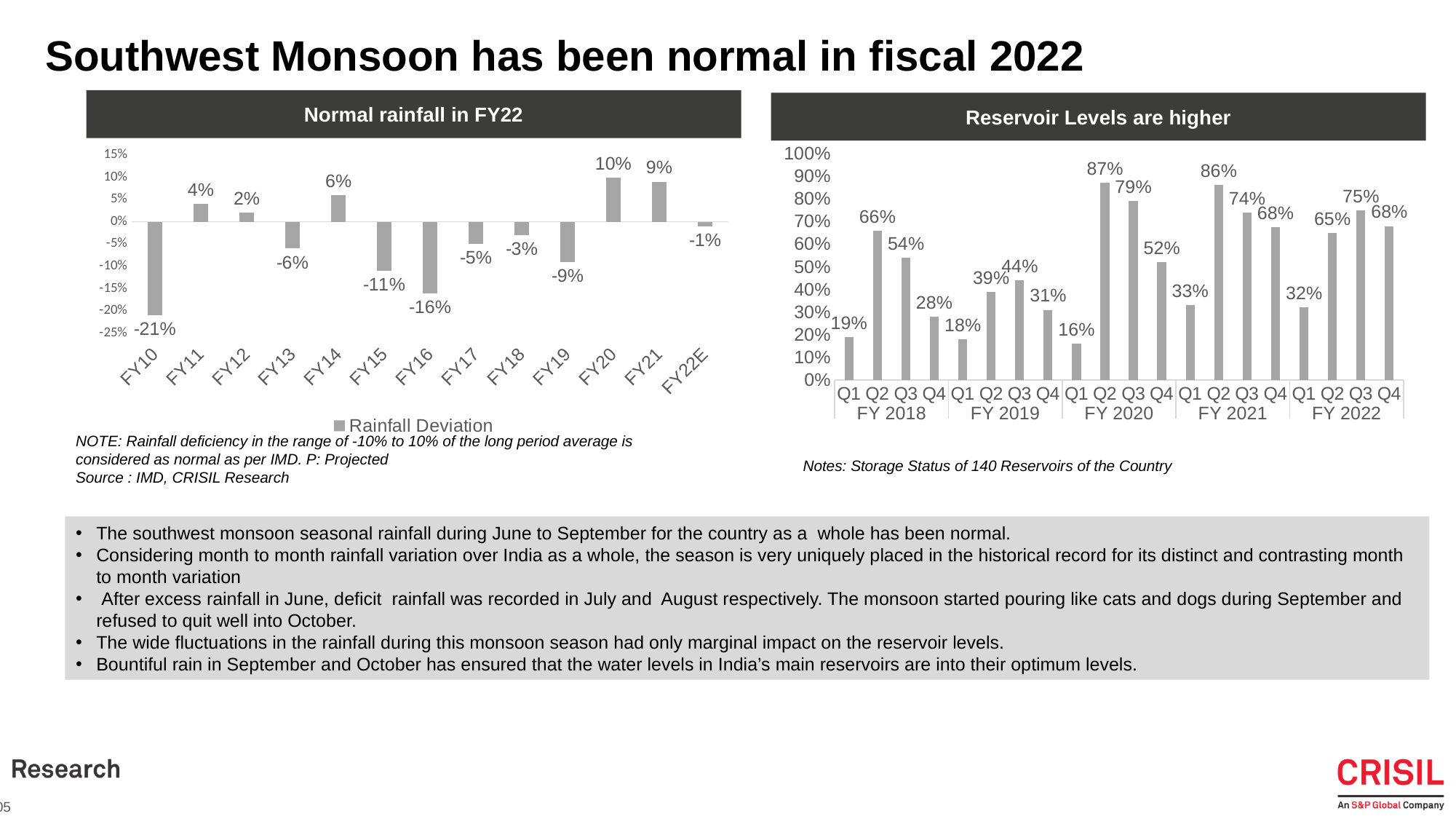
In the 'Reservoir Levels are higher' chart, how many quarterly bars are plotted? 20 In the 'Reservoir Levels are higher' chart, what is the reservoir level in Q2 of FY 2020? 87% In the 'Normal rainfall in FY22' chart, what is the rainfall deviation for FY16? -16% What type of chart is 'Reservoir Levels are higher'? Bar chart In the 'Normal rainfall in FY22' chart, which fiscal year has the highest rainfall deviation? FY20 In the 'Normal rainfall in FY22' chart, what is the difference between the rainfall deviation in FY20 and FY21? 1 percentage point In the 'Normal rainfall in FY22' chart, how many fiscal years are plotted? 13 In the 'Normal rainfall in FY22' chart, what series name does the legend show? Rainfall Deviation In the 'Reservoir Levels are higher' chart, what is the difference between the reservoir levels in Q2 and Q1 of FY 2018? 47 percentage points In the 'Normal rainfall in FY22' chart, which fiscal year has the lowest rainfall deviation? FY10 In the 'Reservoir Levels are higher' chart, which is larger: the reservoir level in Q3 of FY 2022 or Q3 of FY 2021? Q3 of FY 2022 In the 'Reservoir Levels are higher' chart, which quarter has the lowest reservoir level? Q1 FY 2020